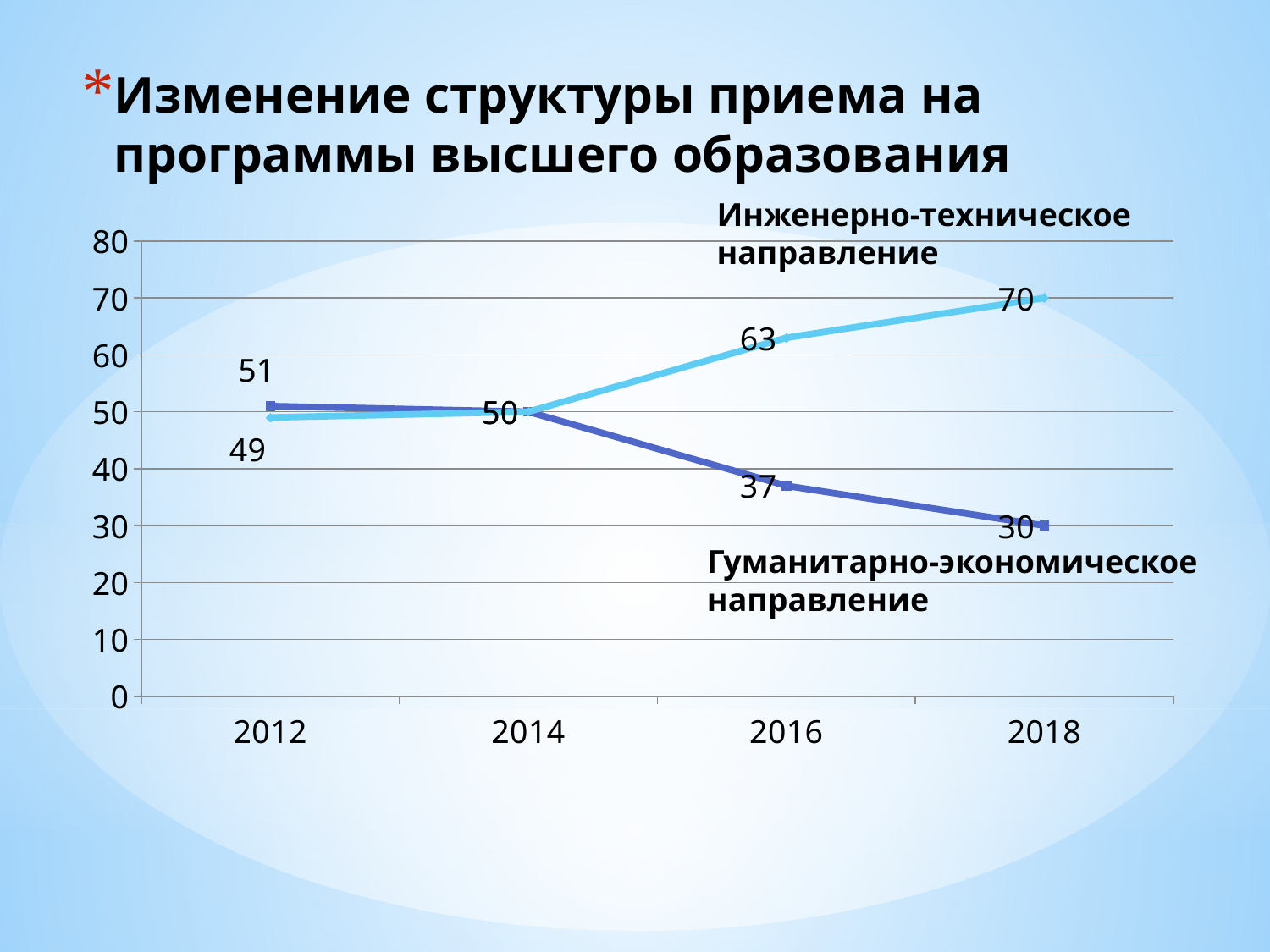
Which series has the larger value in 2012? Гуманитарно-экономическое направление What is the value for Инженерно-техническое направление in 2012? 49 Does the value for Гуманитарно-экономическое направление rise or fall from 2014 to 2018? fall What is the value for Гуманитарно-экономическое направление in 2018? 30 What is the difference between the two series in 2016? 26 In which year does Инженерно-техническое направление reach its highest value? 2018 What is the value for Гуманитарно-экономическое направление in 2016? 37 What is the value for Инженерно-техническое направление in 2018? 70 What is the title of the slide? Изменение структуры приема на программы высшего образования In which year does Гуманитарно-экономическое направление have its lowest value? 2018 What kind of chart is shown on the slide? line chart How many years are shown on the x axis? 4